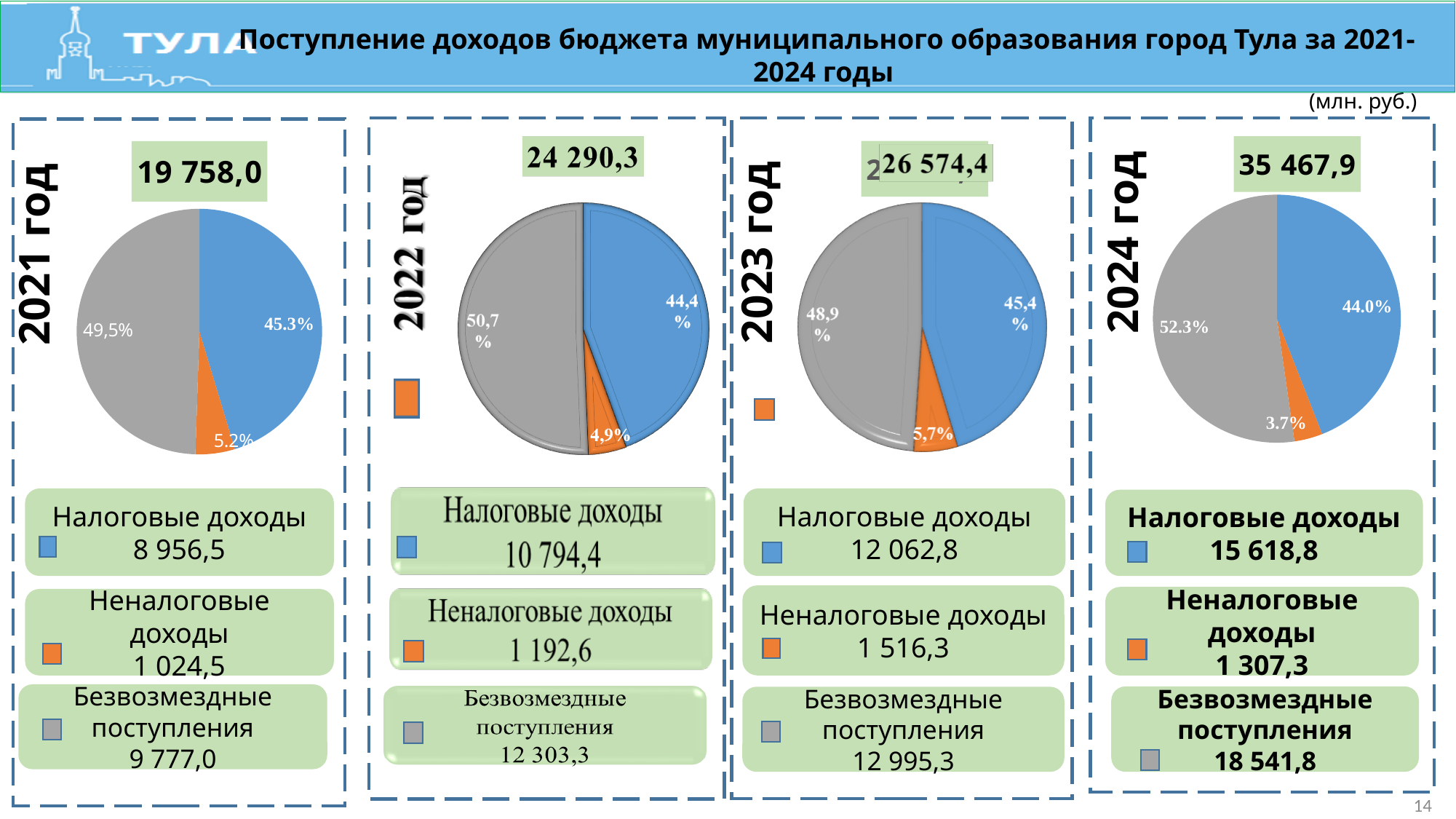
In the 2023 год chart, what is the value of Безвозмездные поступления? 12 995,3 Which colour represents Неналоговые доходы in the pie charts? orange In the 2023 год chart, which category has the smallest slice? Неналоговые доходы In the 2024 год chart, which category has the largest slice? Безвозмездные поступления What type of chart is used for each year on the slide? pie chart In the 2024 год pie chart, what share do Неналоговые доходы have? 3.7% In the 2021 год chart, which is larger: Налоговые доходы or Безвозмездные поступления? Безвозмездные поступления How many slices does each pie chart on the slide have? 3 What total is shown above the 2022 год pie chart? 24 290,3 In the 2021 год pie chart, what share do Безвозмездные поступления have? 49,5% In the 2022 год chart, what is the value of Налоговые доходы? 10 794,4 What is the difference between Налоговые доходы in 2024 год and in 2023 год? 3 556,0